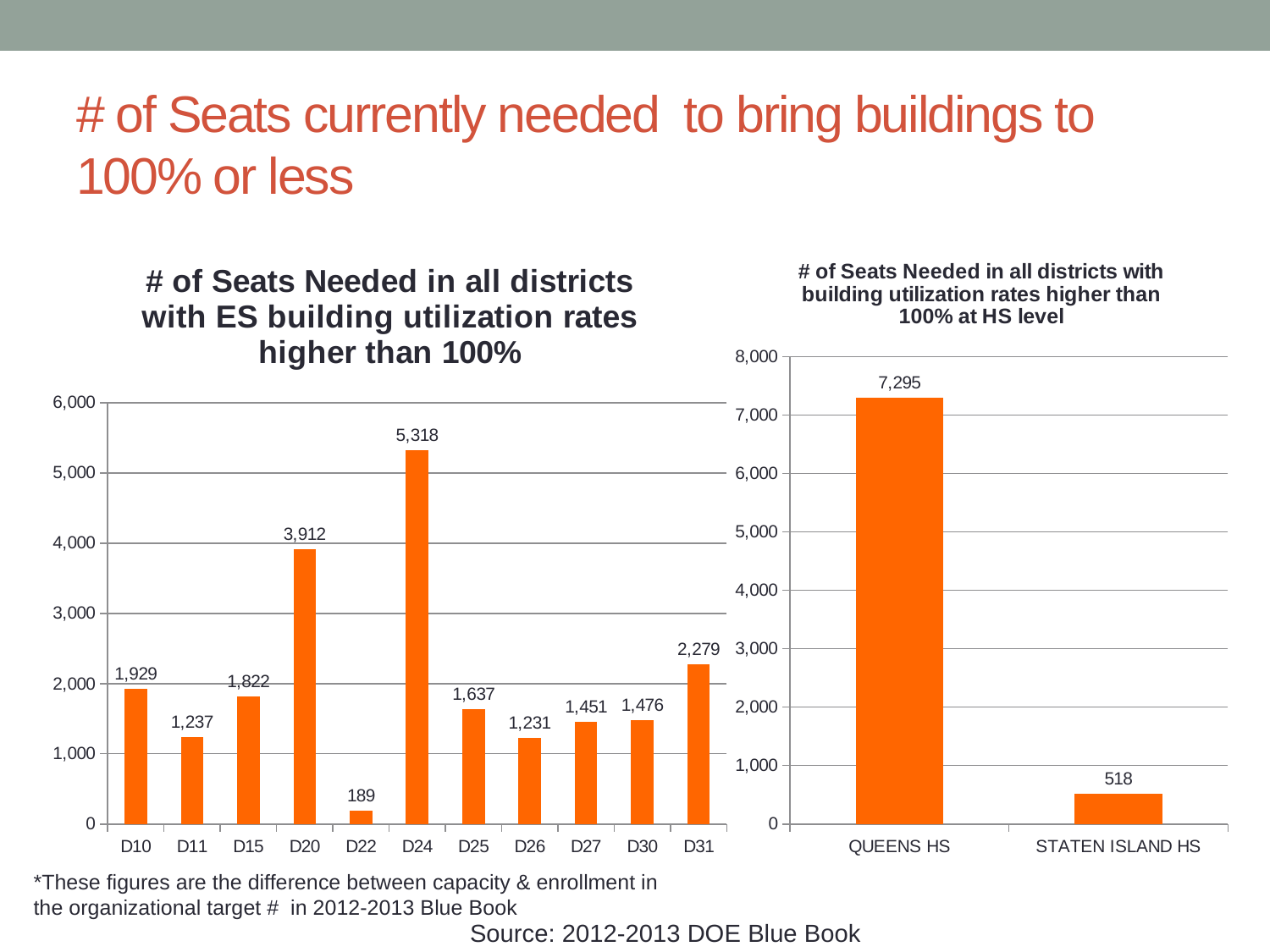
In the left chart (ES building utilization), what is the difference in seats needed between D20 and D10? 1,983 In the left chart (ES building utilization), which district has the lowest number of seats needed? D22 In the right chart (HS level), how many seats are needed for QUEENS HS? 7,295 In the left chart (ES building utilization), which district needs more seats, D11 or D15? D15 In the left chart (ES building utilization), how many districts are shown? 11 In the right chart (HS level), how many seats are needed for STATEN ISLAND HS? 518 What type of chart is the right chart (HS level)? Bar chart In the right chart (HS level), what is the difference in seats needed between QUEENS HS and STATEN ISLAND HS? 6,777 In the left chart (ES building utilization), how many seats are needed in D24? 5,318 In the left chart (ES building utilization), how many seats are needed in D22? 189 In the left chart (ES building utilization), is the value for D31 greater or less than 2,000? greater In the left chart (ES building utilization), which district has the highest number of seats needed? D24